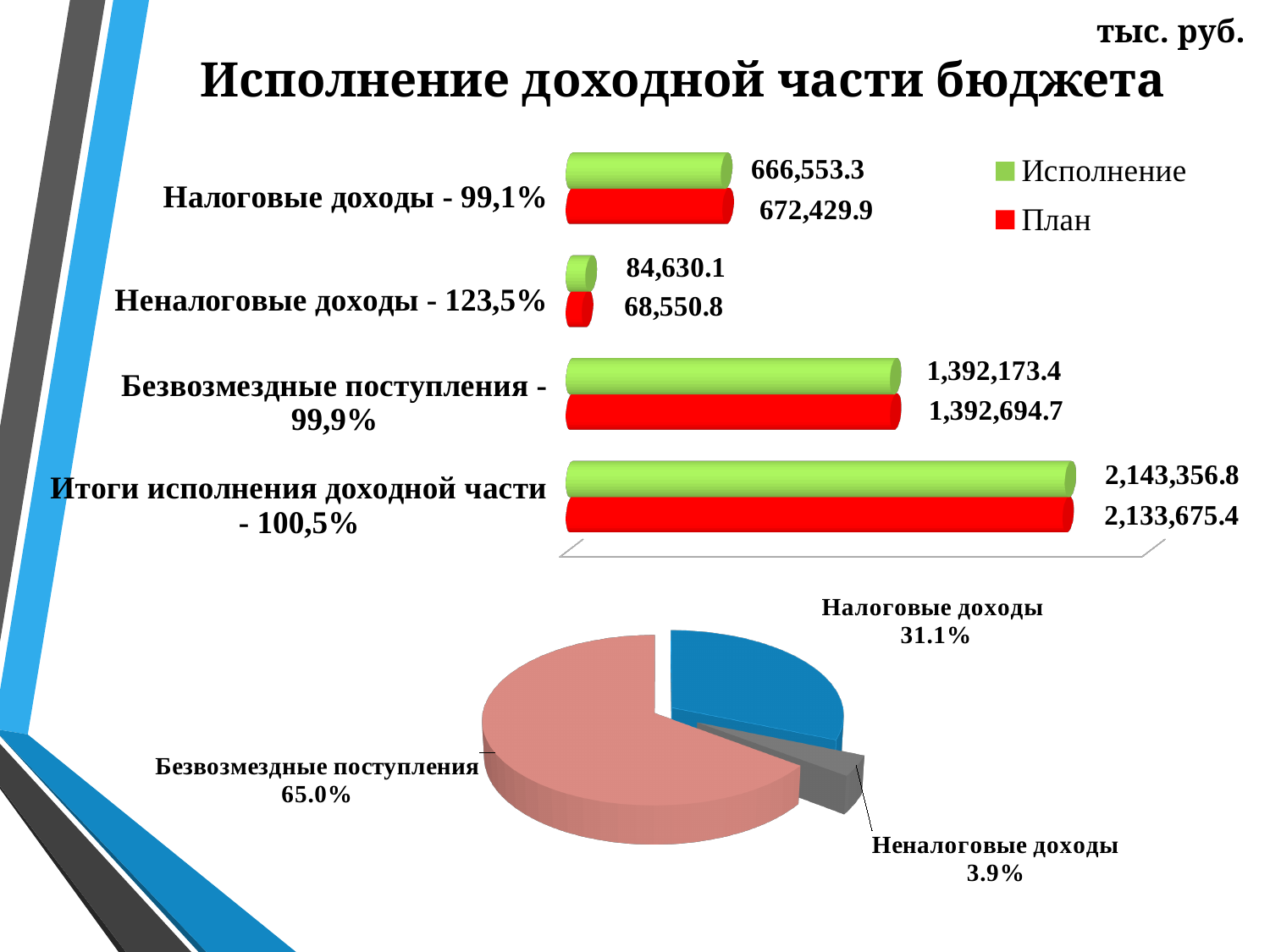
What kind of chart is the top chart on the slide? Bar chart In the top bar chart, which category has the highest Исполнение value? Итоги исполнения доходной части - 100,5% In the bottom pie chart, which slice is the smallest? Неналоговые доходы In the top bar chart, what is the План value for Неналоговые доходы - 123,5%? 68,550.8 In the top bar chart, which is larger for Безвозмездные поступления - 99,9%: the Исполнение value or the План value? План In the top bar chart, what is the difference between the Исполнение and План values for Неналоговые доходы - 123,5%? 16,079.3 In the top bar chart, which category has the lowest План value? Неналоговые доходы - 123,5% In the top bar chart, what is the Исполнение value for Налоговые доходы - 99,1%? 666,553.3 In the top bar chart, what is the difference between the План and Исполнение values for Налоговые доходы - 99,1%? 5,876.6 In the bottom pie chart, what share does Безвозмездные поступления have? 65.0% How many series does the legend of the top bar chart list? 2 In the top bar chart, what is the Исполнение value for Итоги исполнения доходной части - 100,5%? 2,143,356.8